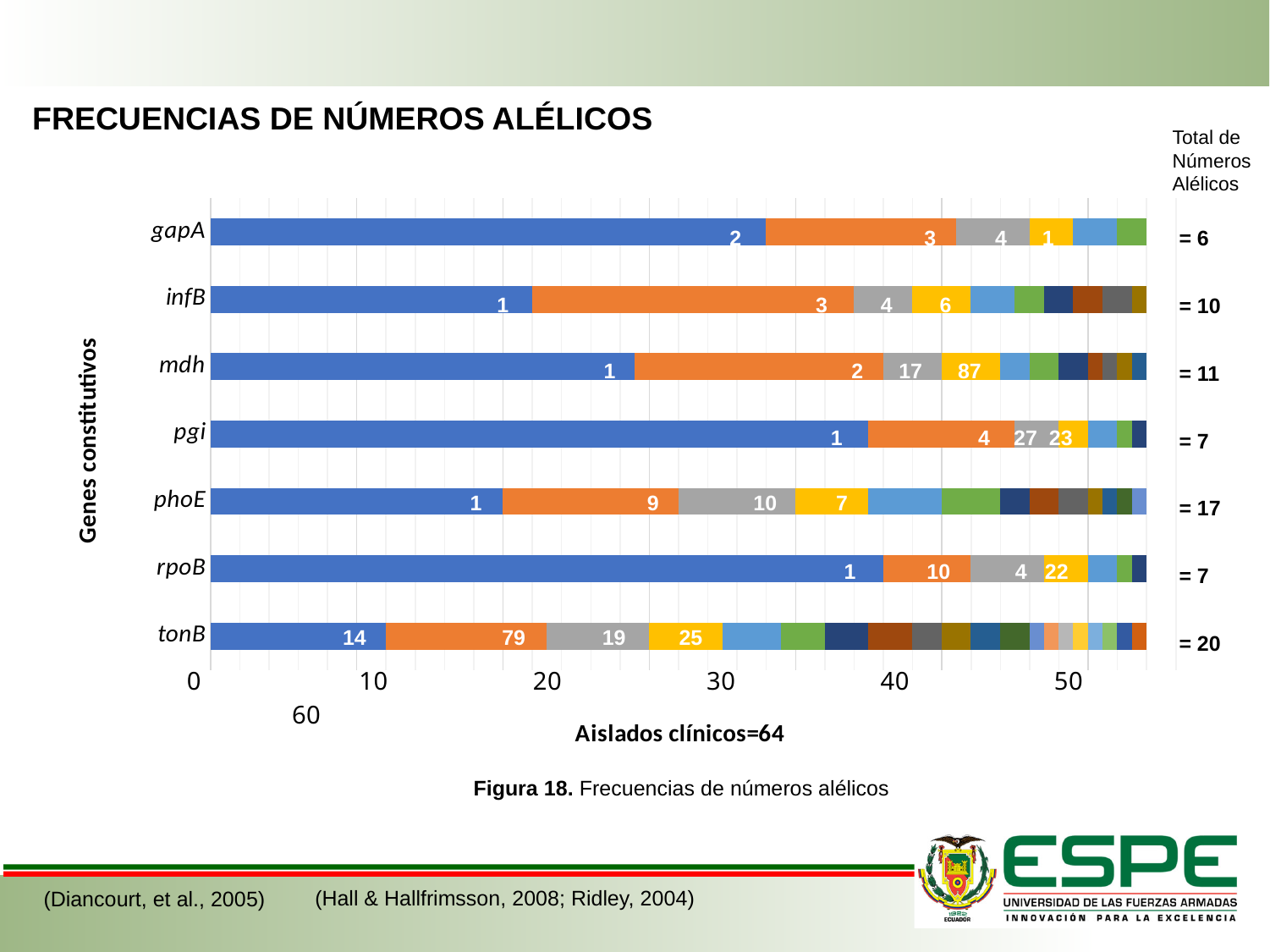
According to the 'Total de Números Alélicos' annotation, how many allele numbers does gapA have? 6 Which gene has the shortest first (blue) segment? tonB Which has a longer first (blue) segment, pgi or gapA? pgi What is the title of the chart? FRECUENCIAS DE NÚMEROS ALÉLICOS What kind of chart is shown on the slide? stacked bar chart Which gene has the smallest total number of allele numbers according to the annotations on the right? gapA Is the length of the first (blue) segment for gapA greater or less than 30? greater Which gene has the largest total number of allele numbers according to the annotations on the right? tonB What is the label of the x axis? Aislados clínicos=64 Is the length of the first (blue) segment for phoE greater or less than 20? less How many genes (categories) are plotted on the y axis? 7 According to the 'Total de Números Alélicos' annotation, how many allele numbers does tonB have? 20